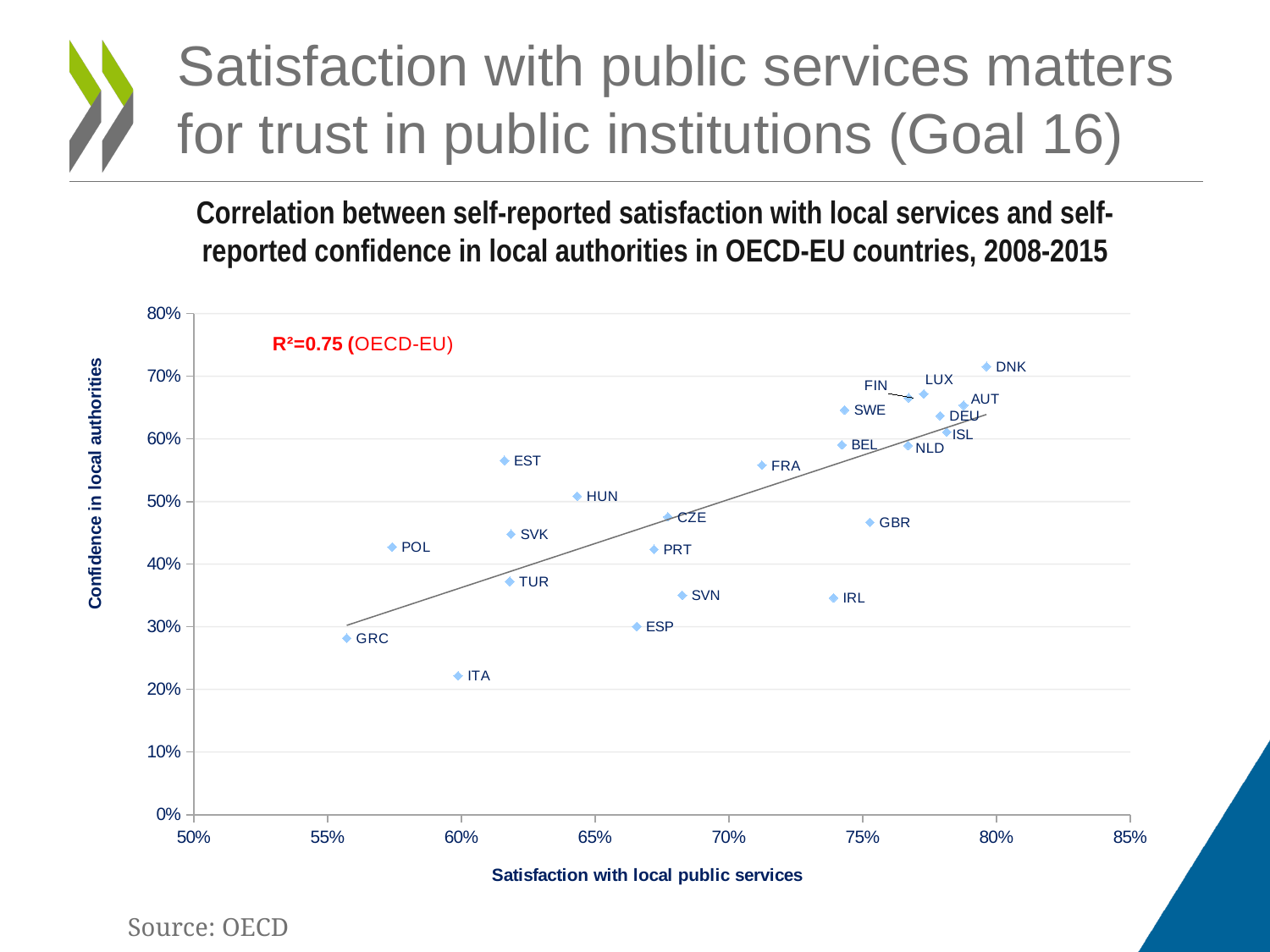
Which country has the lowest confidence in local authorities? ITA Which country has the lowest satisfaction with local public services? GRC Which has higher confidence in local authorities, GBR or IRL? GBR Which country has the highest confidence in local authorities? DNK What R² value is shown on the chart for OECD-EU? 0.75 Is the confidence in local authorities for SVN greater or less than 40%? less Is the confidence in local authorities for GBR greater or less than 50%? less Is the confidence in local authorities for DNK greater or less than 70%? greater Does confidence in local authorities generally rise or fall as satisfaction with local public services increases? rise What kind of chart is shown on the slide? Scatter chart